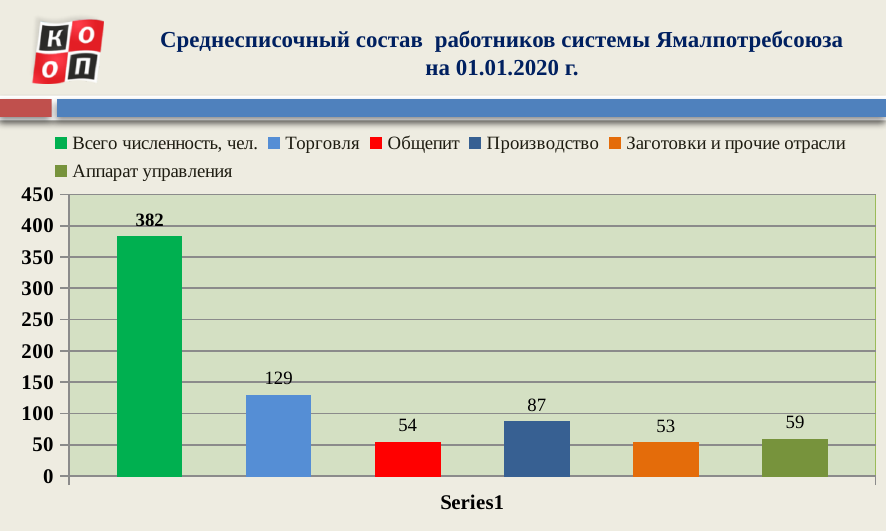
How many series does the legend list? 6 How many bars are plotted on the chart? 6 Is the value for Производство greater or less than 100? less What kind of chart is shown on the slide? bar chart What is the difference between the values for Торговля and Производство? 42 What is the value for Аппарат управления? 59 What is the value for Всего численность, чел.? 382 What is the value for Производство? 87 Which series has the lowest value? Заготовки и прочие отрасли What is the value for Торговля? 129 Which is larger, the value for Общепит or the value for Аппарат управления? Аппарат управления Which series has the highest value? Всего численность, чел.